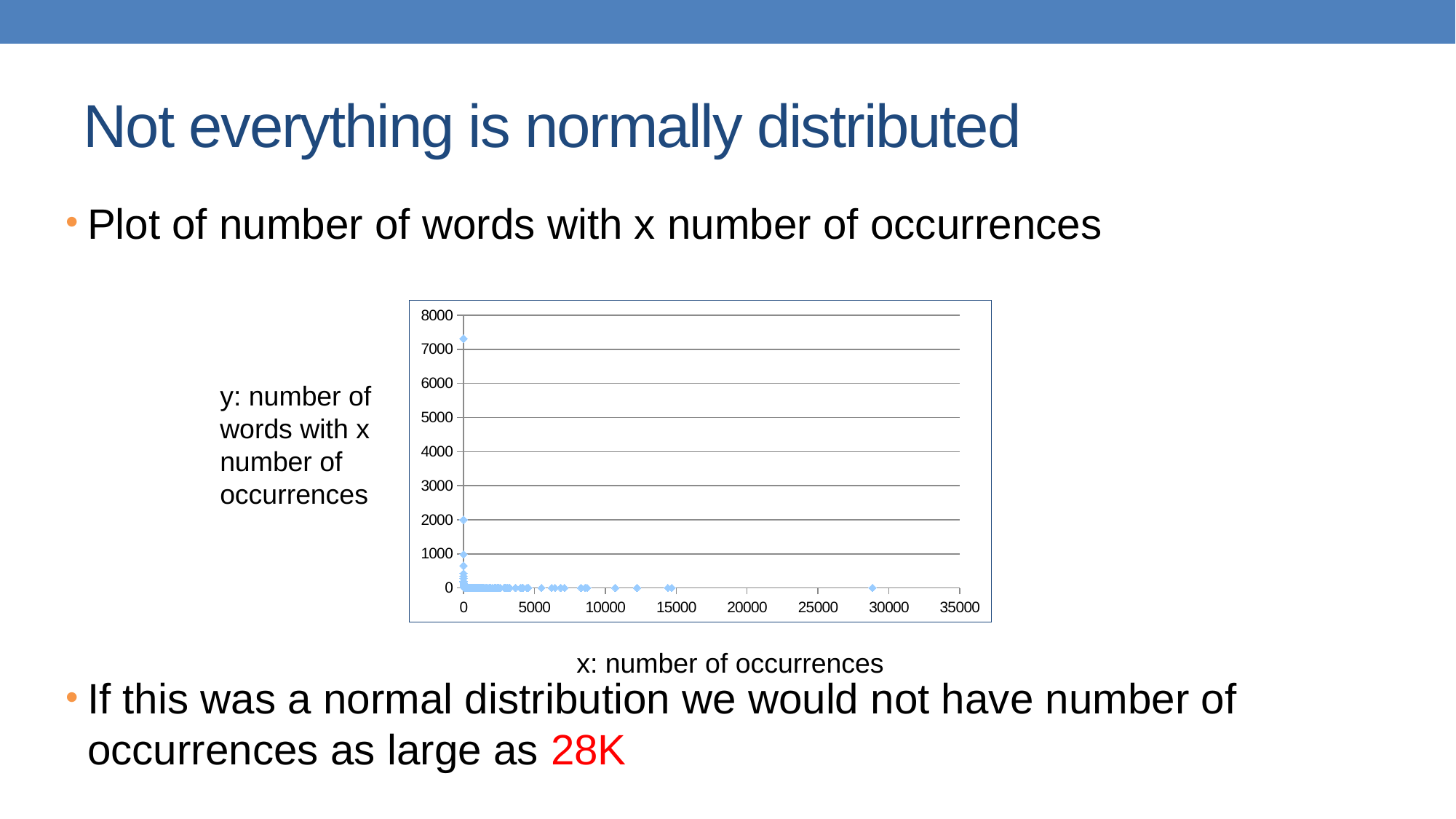
What is the maximum value shown on the chart's x axis? 35000 As the number of occurrences (x) increases, do the plotted y values generally rise or fall? fall What is the maximum value shown on the chart's y axis? 8000 Is the largest x value (number of occurrences) plotted on the chart greater or less than 30000? less Is the highest y value plotted on the chart greater or less than 8000? less Is the highest y value plotted on the chart greater or less than 7000? greater Where along the x axis is the point with the highest y value located: near 0 or near 35000? near 0 What kind of chart is shown on the slide? scatter plot